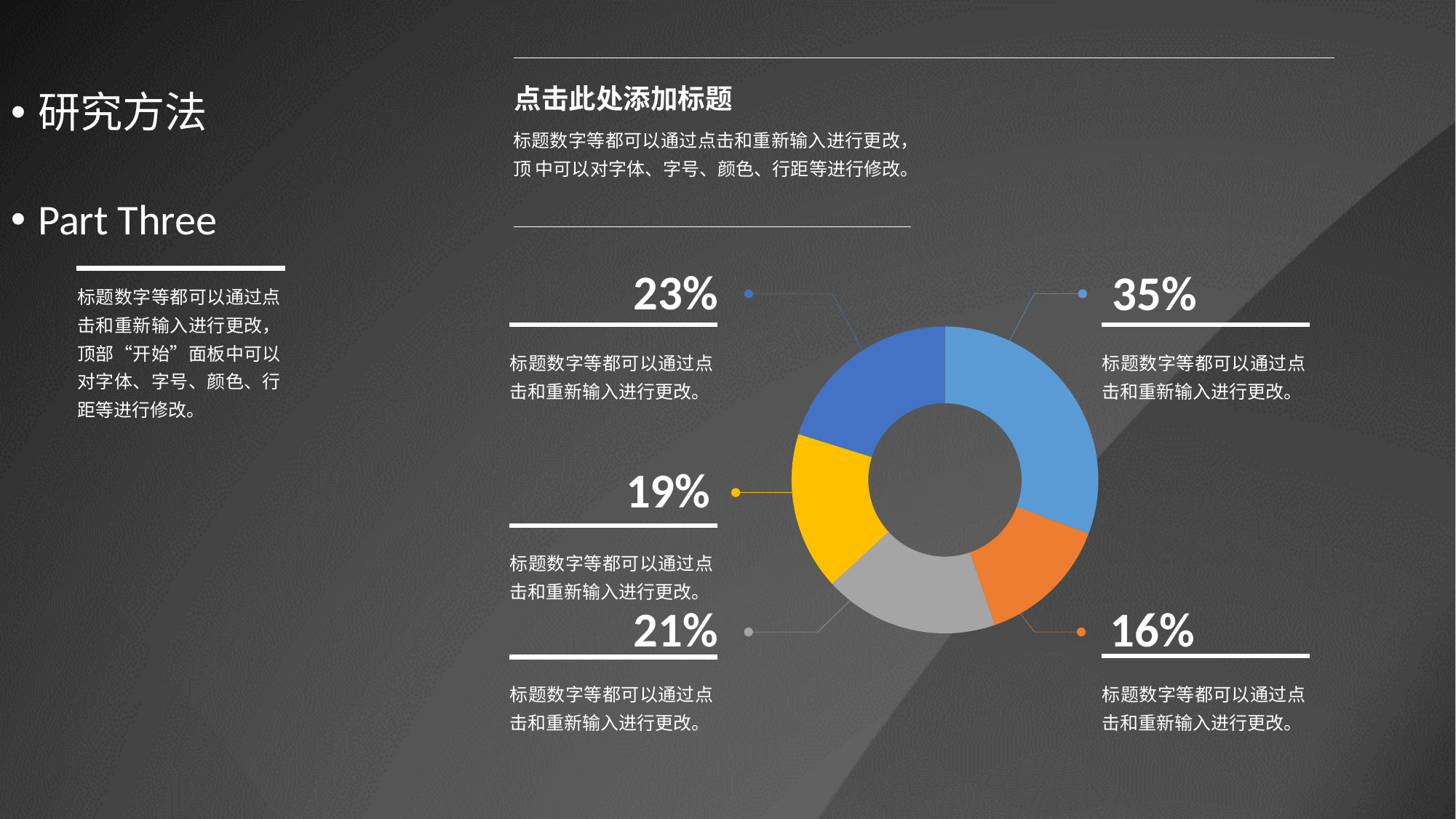
What is the combined share of the gray and orange slices in the donut chart? 37% What percentage is shown for the light blue slice of the donut chart? 35% Which slice of the donut chart has the smallest share? The orange slice (16%) How many slices does the donut chart have? 5 Which slice of the donut chart has the largest share? The light blue slice (35%) Which is larger in the donut chart, the dark blue slice or the yellow slice? The dark blue slice (23%) What percentage is shown for the dark blue slice of the donut chart? 23% What is the difference between the largest slice (35%) and the smallest slice (16%) in the donut chart? 19% What percentage is shown for the yellow slice of the donut chart? 19% What percentage is shown for the orange slice of the donut chart? 16% What percentage is shown for the gray slice of the donut chart? 21% What kind of chart is shown on the slide? Donut chart